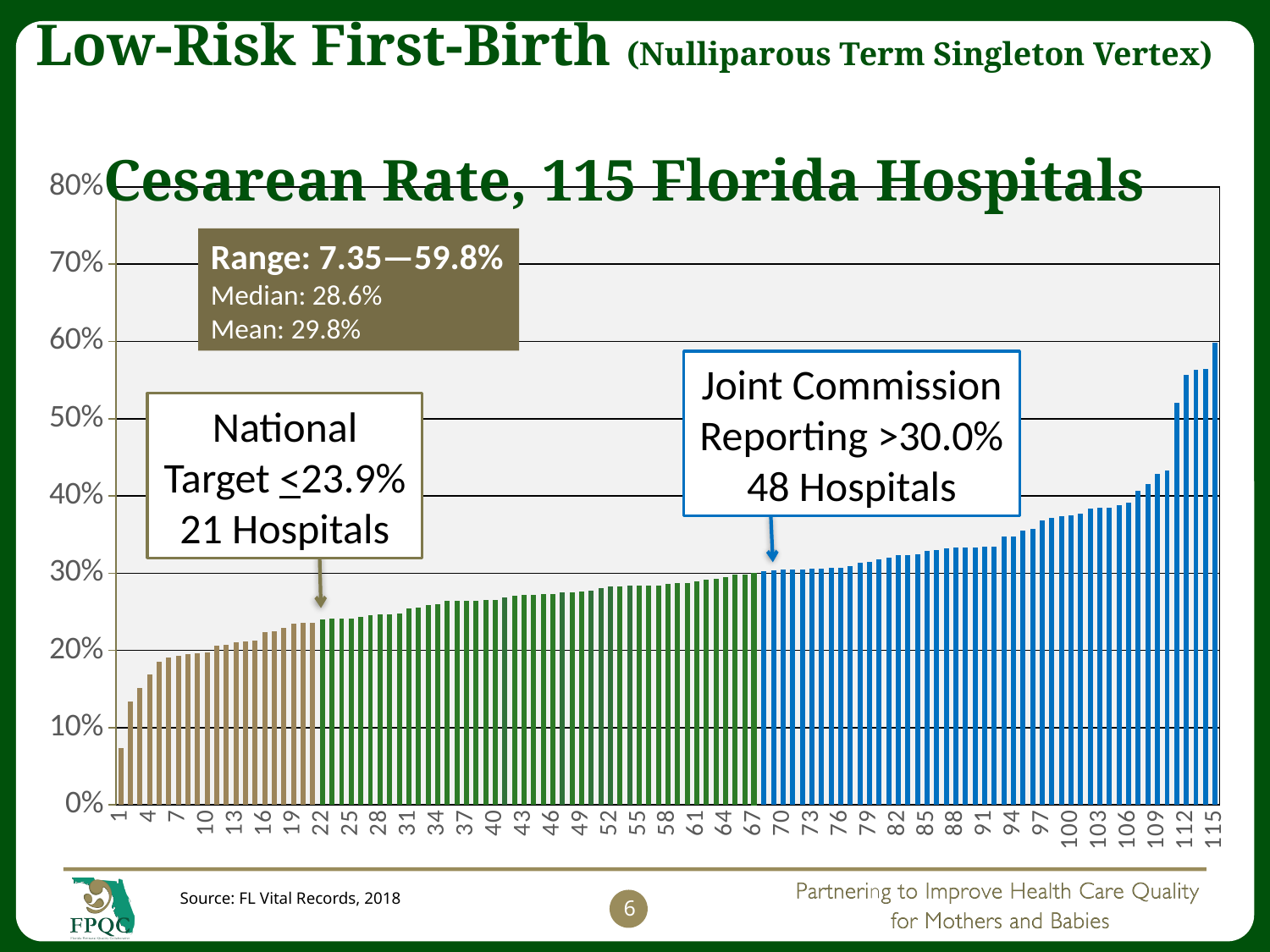
Which hospital has the larger cesarean rate, hospital 10 or hospital 90? hospital 90 How many Florida hospitals are plotted in the chart? 115 Is the cesarean rate for hospital 100 greater or less than 30%? greater According to the annotation on the chart, what is the median cesarean rate? 28.6% According to the annotation on the chart, how many hospitals have Joint Commission reporting rates above 30.0%? 48 Hospitals Is the cesarean rate for hospital 115 greater or less than 50%? greater Which hospital number has the highest cesarean rate? 115 What kind of chart is shown on the slide? bar chart Is the cesarean rate for hospital 40 greater or less than 30%? less Do the cesarean rates rise or fall moving from hospital 1 to hospital 115 along the x axis? rise Which hospital number has the lowest cesarean rate? 1